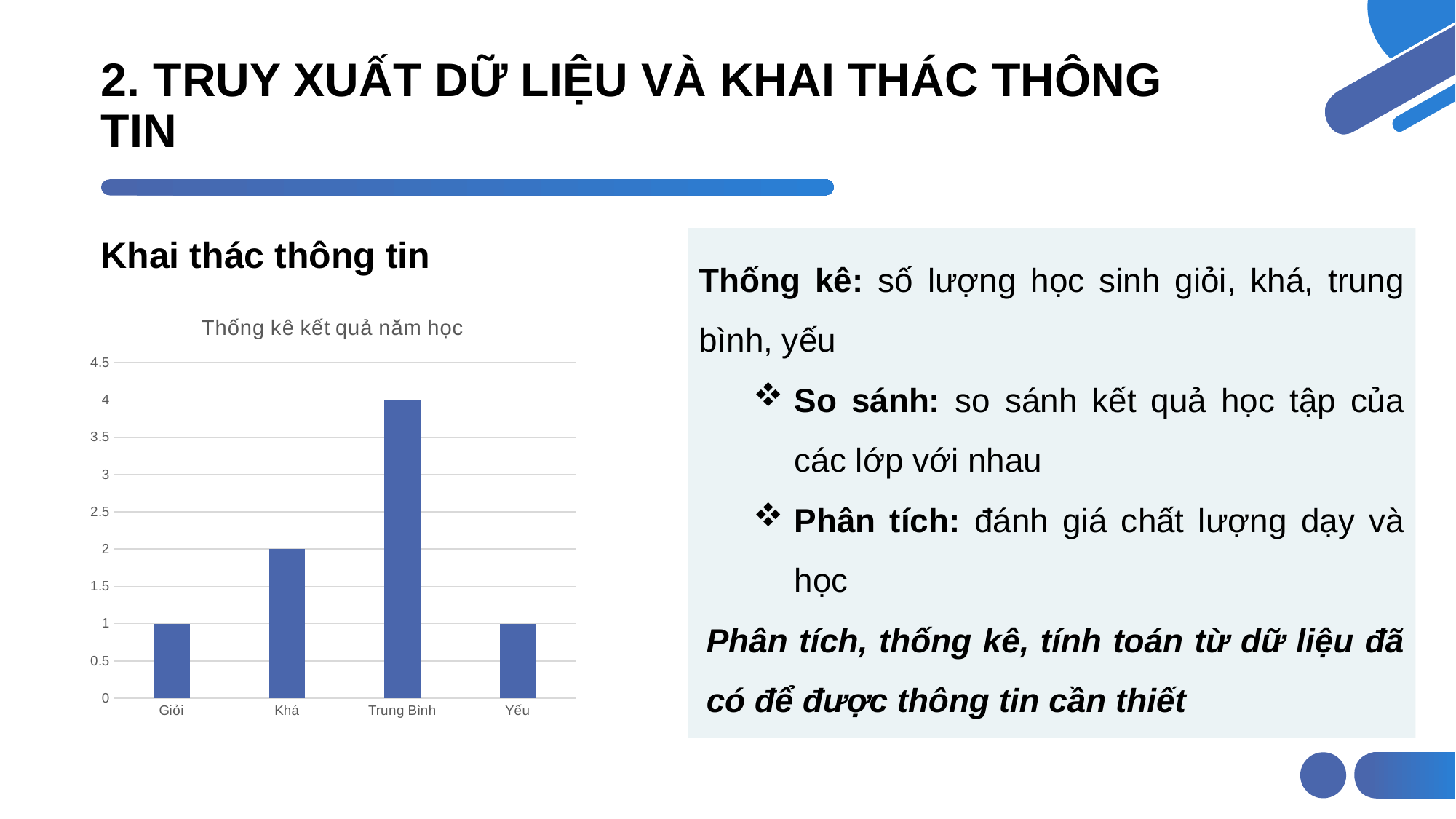
What is the difference between the values for Trung Bình and Khá? 2 Which category has the highest value? Trung Bình What is the value for Yếu? 1 How many categories are shown on the x axis of the chart? 4 Which is larger, the value for Khá or the value for Giỏi? Khá What is the value for Trung Bình? 4 What type of chart is shown on the slide? bar chart What is the value for Giỏi? 1 What is the highest value shown on the y axis of the chart? 4.5 What is the title of the chart? Thống kê kết quả năm học Is the value for Trung Bình greater or less than 3? greater What is the value for Khá? 2